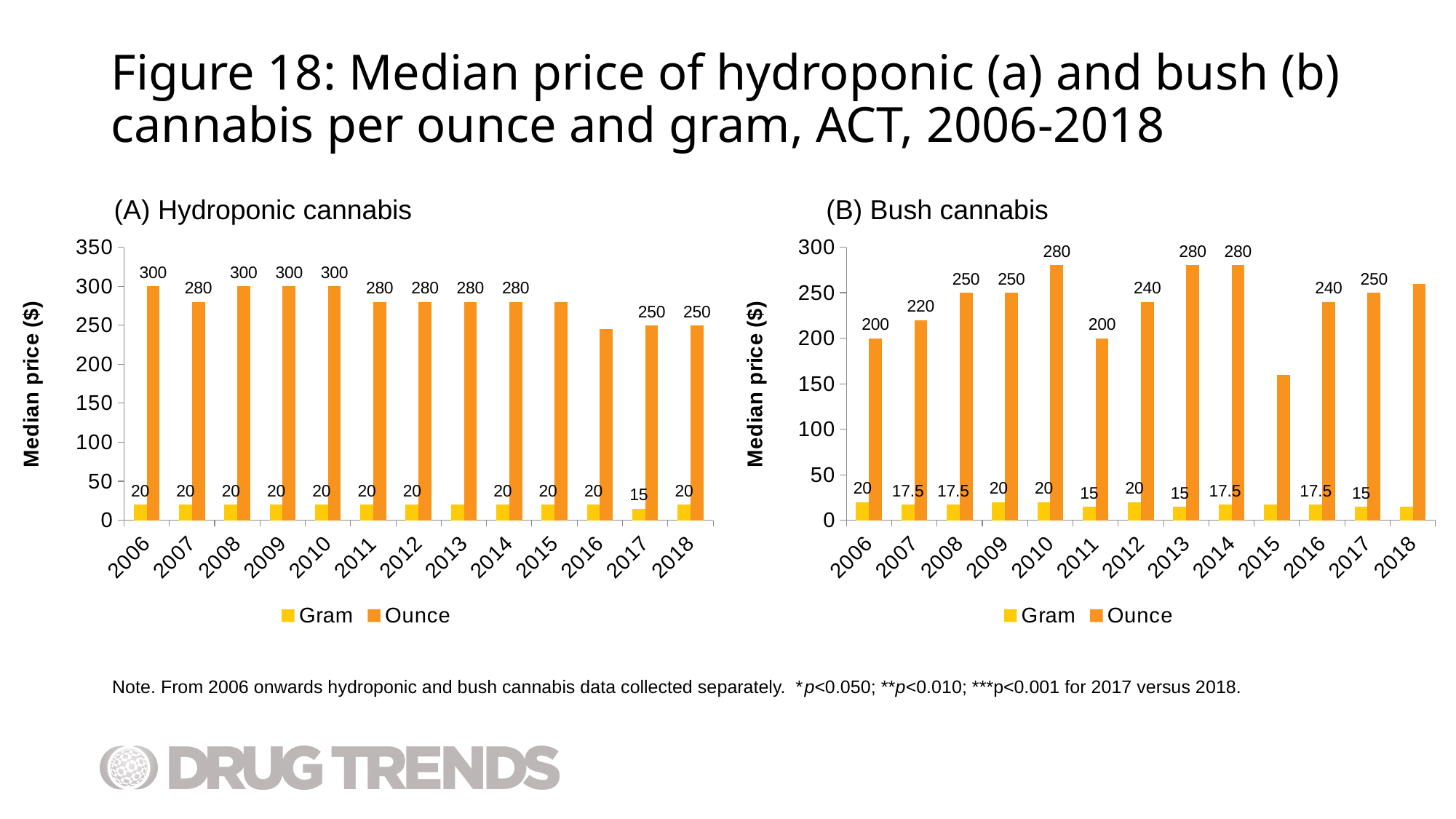
In the (A) Hydroponic cannabis chart, is the ounce price for 2016 greater or less than 200? greater How many years are shown on the x axis of the (A) Hydroponic cannabis chart? 13 In the (B) Bush cannabis chart, which year has the lowest median price per ounce? 2015 In the (B) Bush cannabis chart, which year has the higher ounce price, 2011 or 2012? 2012 In the (B) Bush cannabis chart, is the ounce price for 2015 greater or less than 200? less How many series does the legend of the (B) Bush cannabis chart list? 2 In the (B) Bush cannabis chart, what is the difference between the ounce price in 2007 and the ounce price in 2006? 20 In the (B) Bush cannabis chart, what is the median price per gram in 2007? 17.5 In the (A) Hydroponic cannabis chart, how much higher is the ounce price in 2006 than in 2018? 50 In the (A) Hydroponic cannabis chart, what is the median price per ounce in 2006? 300 In the (B) Bush cannabis chart, what is the median price per ounce in 2010? 280 In the (A) Hydroponic cannabis chart, what is the median price per gram in 2017? 15